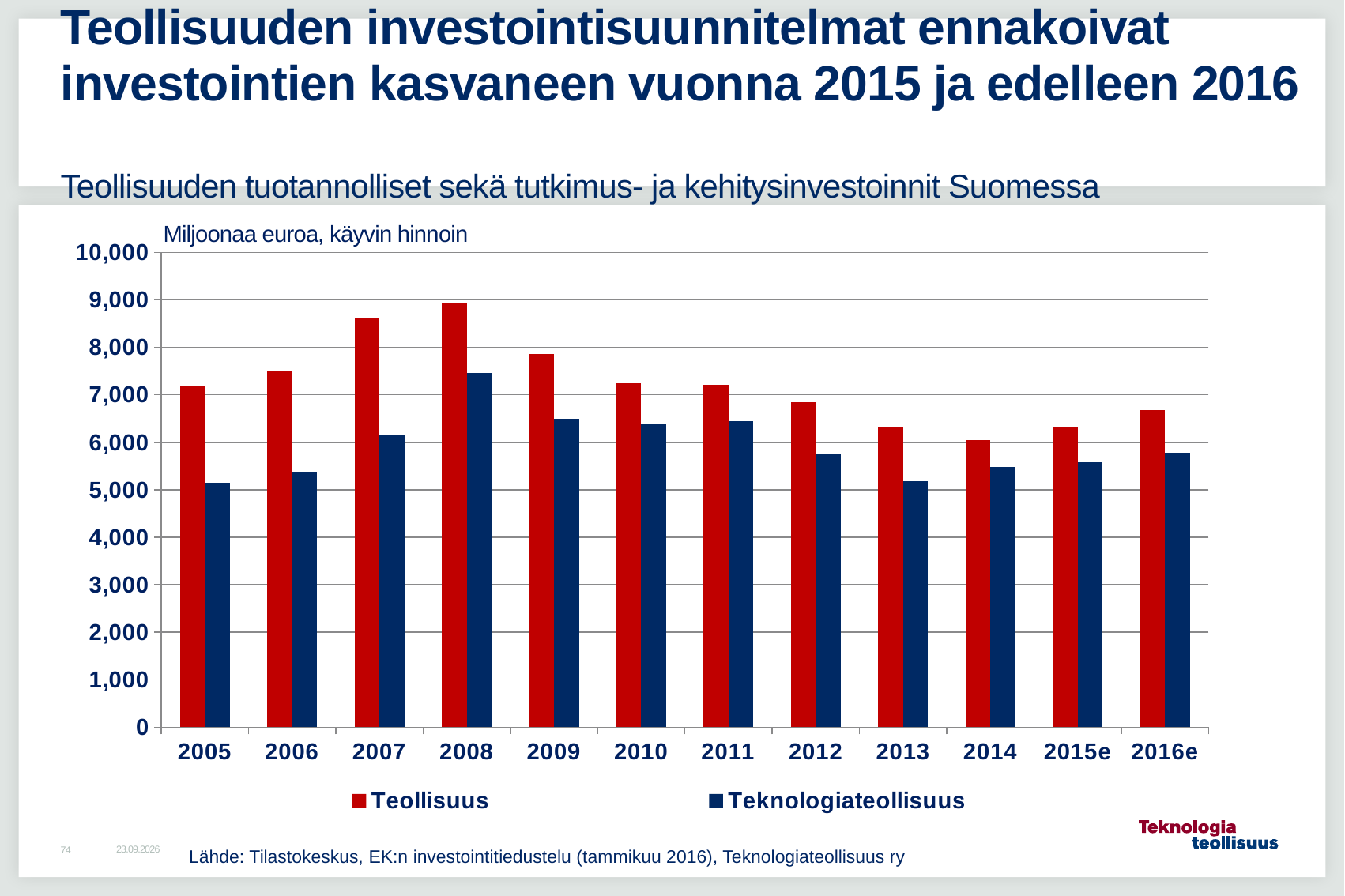
Is the Teknologiateollisuus value for 2012 greater or less than 6,000? less Which is larger in 2008, Teollisuus or Teknologiateollisuus? Teollisuus What unit is stated above the chart? Miljoonaa euroa, käyvin hinnoin In which year is the Teollisuus value highest? 2008 Is the Teollisuus value for 2008 greater or less than 8,000? greater How many series does the legend list? 2 In which year is the Teknologiateollisuus value highest? 2008 Does the Teollisuus value rise or fall from 2008 to 2014? fall What kind of chart is shown on the slide? bar chart In which year is the Teollisuus value lowest? 2014 How many years are shown on the x axis? 12 Is the Teknologiateollisuus value for 2008 greater or less than 7,000? greater